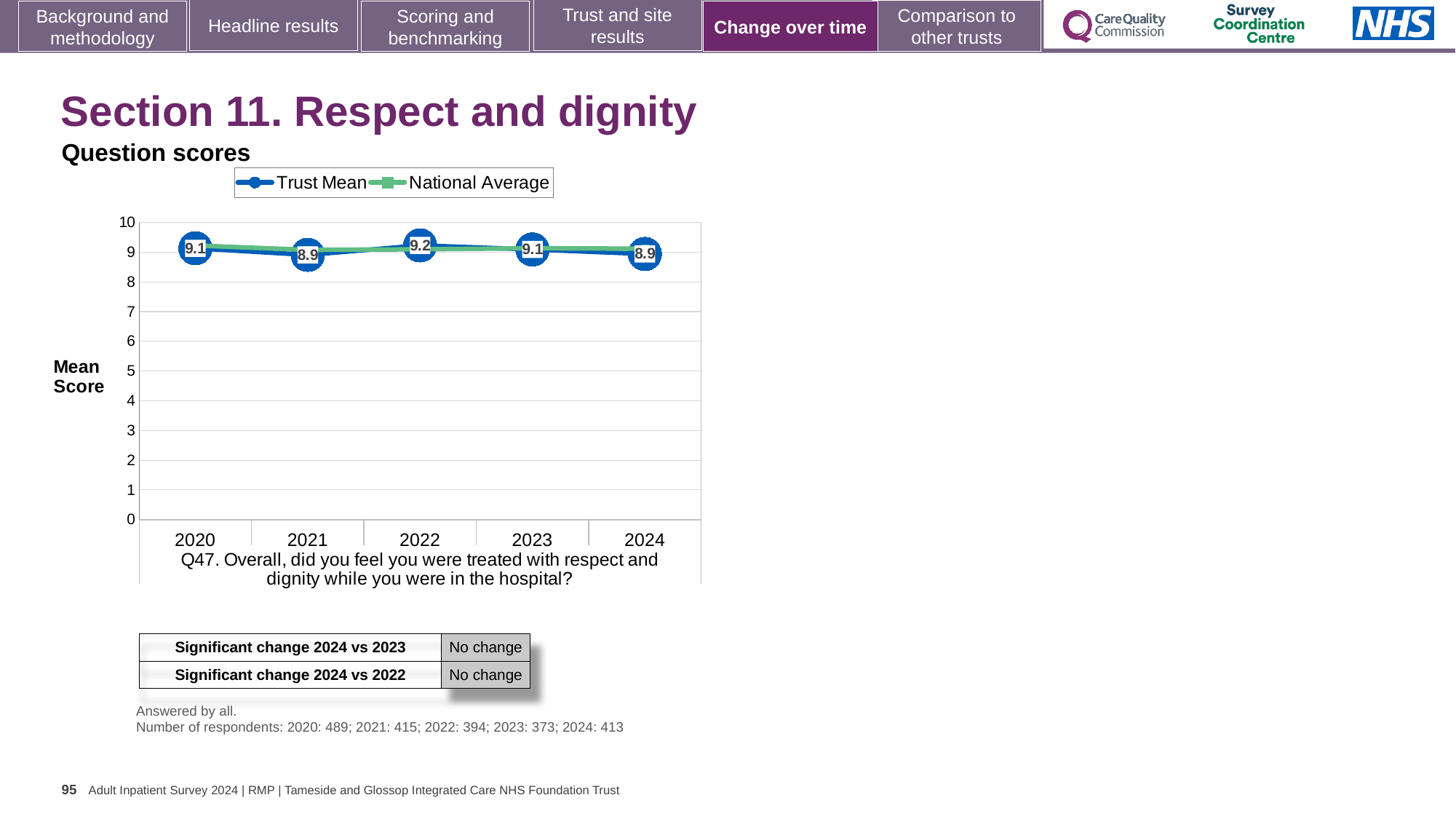
Is the National Average value for 2023 greater or less than 8? greater What kind of chart is shown on the slide? Line chart In which year is the Trust Mean score highest? 2022 How many series does the chart legend list? 2 What is the Trust Mean score for 2022 on the Q47 chart? 9.2 What is the Trust Mean score for 2020? 9.1 What is the difference between the Trust Mean scores for 2022 and 2021? 0.3 Does the Trust Mean score rise or fall from 2022 to 2024? Fall How many years are plotted on the x axis of the chart? 5 What is the Trust Mean score for 2024? 8.9 What is the label of the y axis on the chart? Mean Score Which year has the larger Trust Mean score, 2022 or 2024? 2022